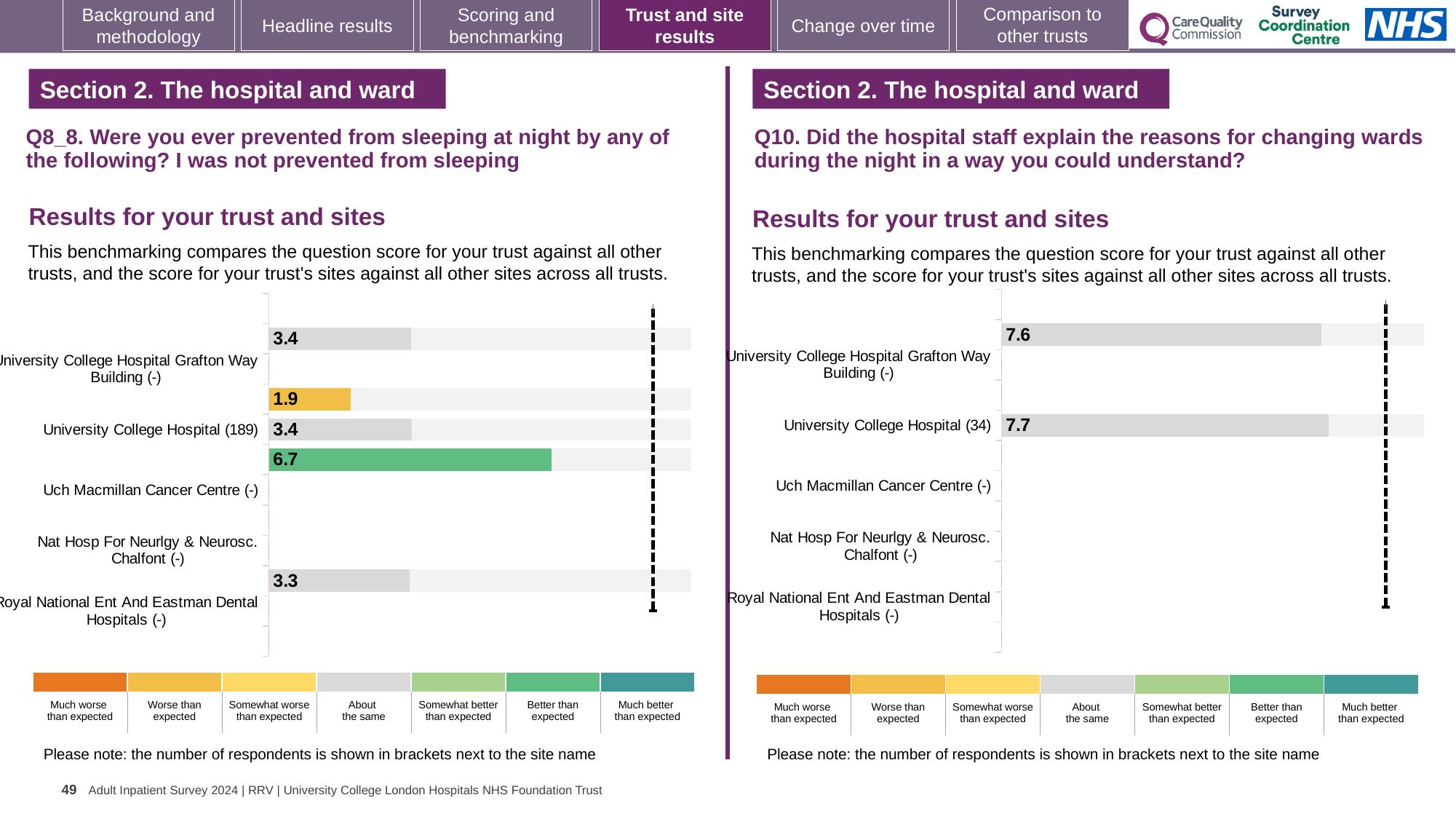
On the left chart (Q8_8), what is the difference between the highest and lowest bar values? 4.8 On the right chart (Q10), how many bars have a value label? 2 What type of chart is used on the left side of the slide (Q8_8)? Bar chart On the left chart (Q8_8), what is the highest value shown on any bar? 6.7 On the left chart (Q8_8), how many bars have a value label? 5 On the left chart (Q8_8), what is the value for University College Hospital (189)? 3.4 On the left chart (Q8_8), what is the lowest value shown on any bar? 1.9 How many categories does the colour key below each chart list? 7 On the right chart (Q10), what is the value for University College Hospital (34)? 7.7